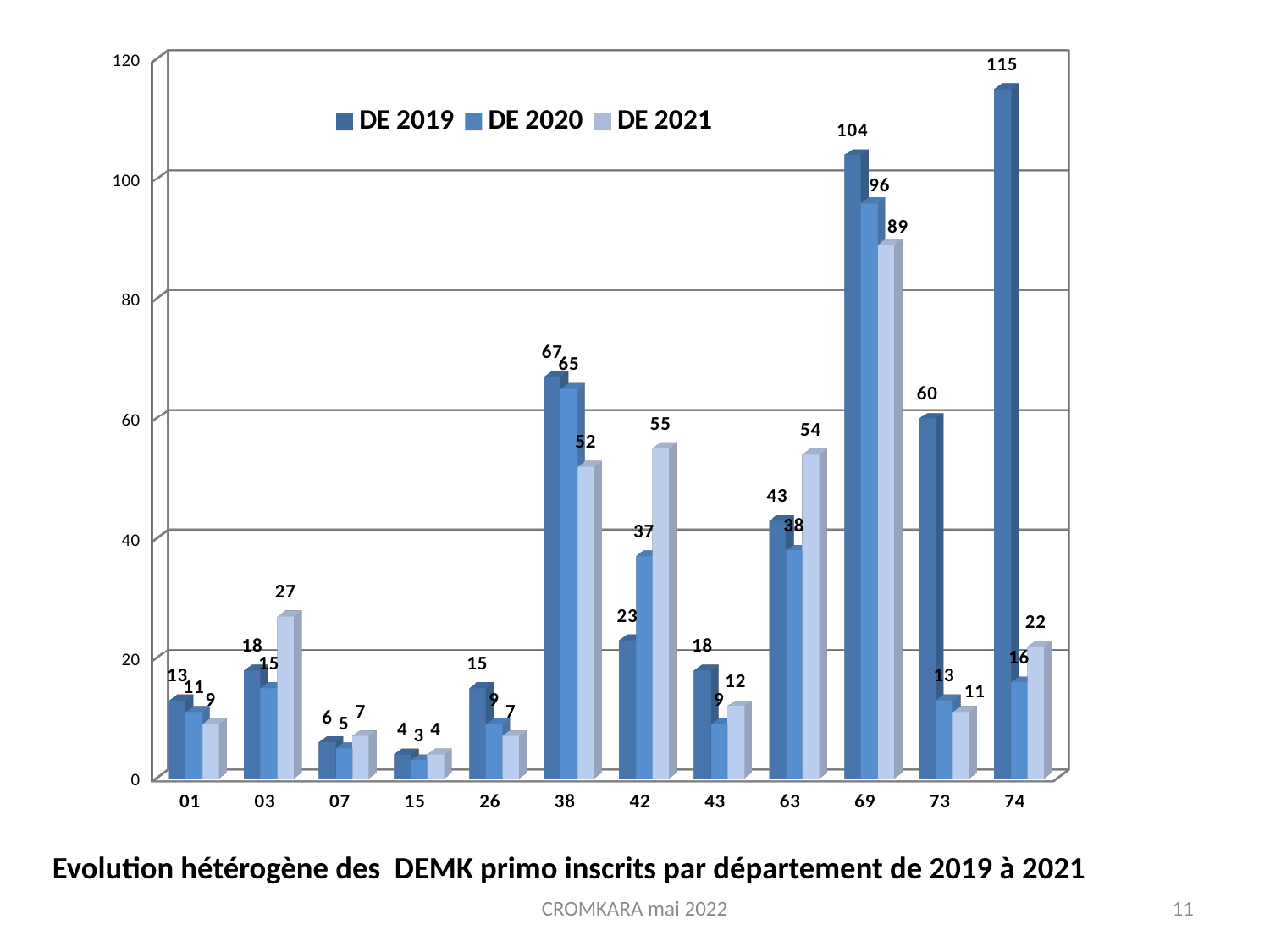
For department 63, which is larger: the DE 2019 value or the DE 2021 value? DE 2021 Which department has the lowest DE 2020 value? 15 What is the DE 2020 value for department 69? 96 Which department has the highest DE 2021 value? 69 What is the title text shown below the chart? Evolution hétérogène des DEMK primo inscrits par département de 2019 à 2021 What is the DE 2019 value for department 74? 115 How many series does the legend list? 3 What is the DE 2021 value for department 42? 55 Is the DE 2019 value for department 69 greater or less than 100? greater How many departments are shown on the x axis? 12 What kind of chart is shown on the slide? bar chart What is the difference between the DE 2019 and DE 2020 values for department 74? 99